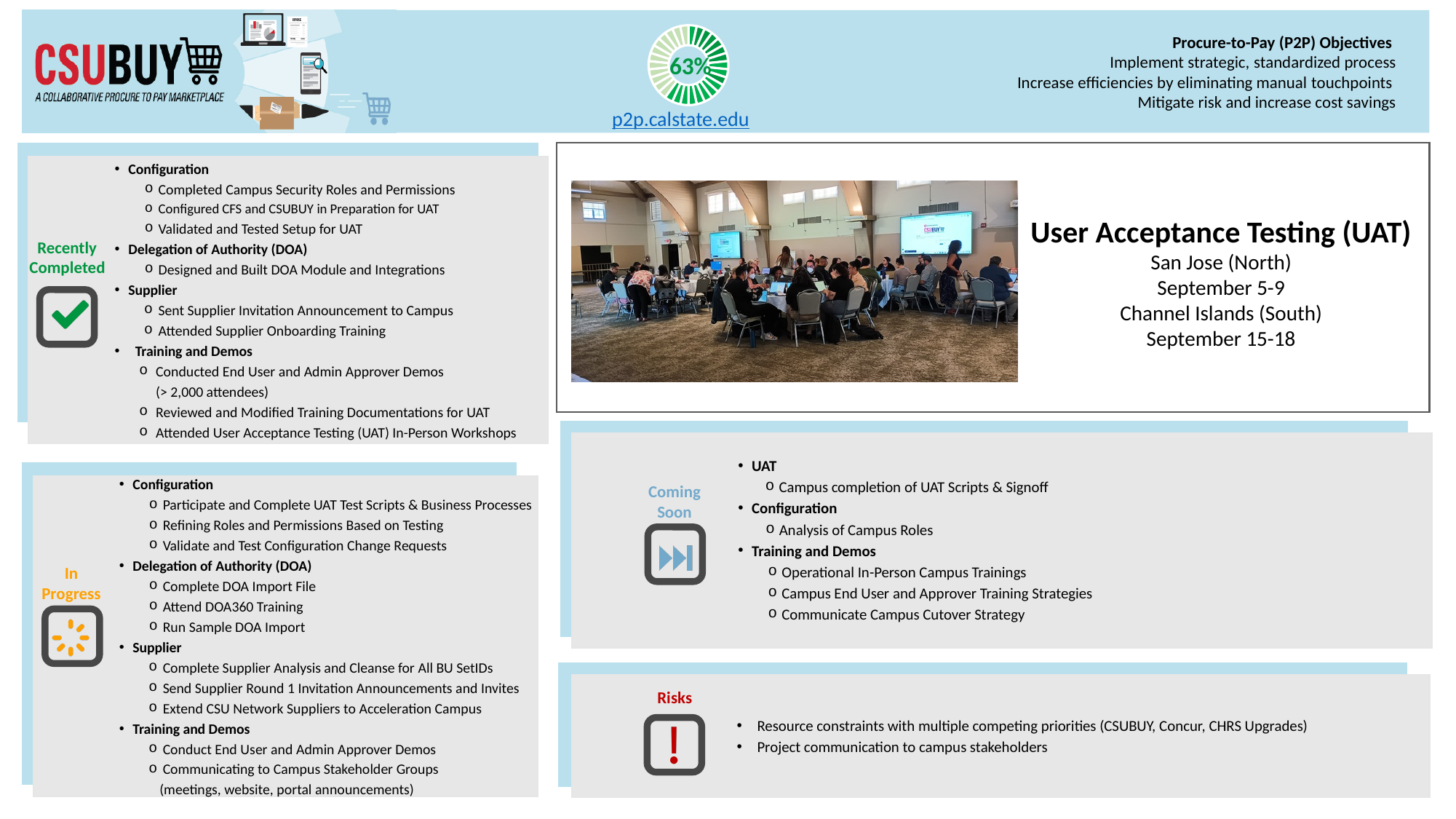
What colour is the filled portion of the circular progress chart? green What web address is printed directly below the circular progress chart? p2p.calstate.edu Is the value shown in the circular progress chart greater or less than 50%? greater What kind of chart is the circular graphic showing 63% at the top of the slide? doughnut (progress ring) chart Is the value shown in the circular progress chart greater or less than 75%? less What percentage is shown in the centre of the circular progress chart at the top of the slide? 63% What share of the circular progress chart is filled (completed)? 63% What share of the circular progress chart remains unfilled? 37%